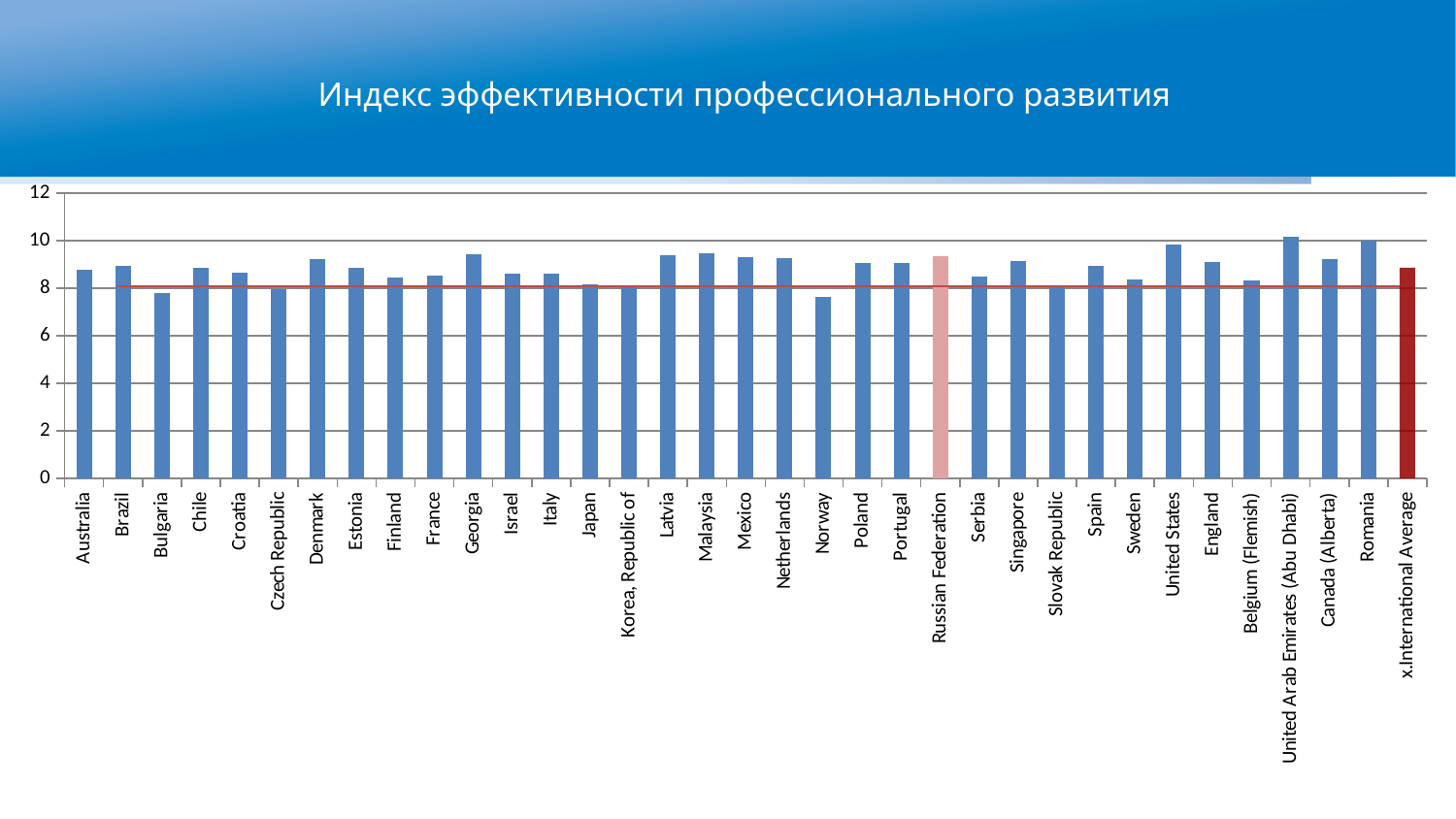
Which category has the lowest value? Norway Is the value for Georgia greater or less than 8? greater Is the value for Norway greater or less than 8? less How many categories (bars) are shown on the x axis? 35 Which is larger, the value for United States or the value for Slovak Republic? United States What is the title of the chart? Индекс эффективности профессионального развития Is the value for United Arab Emirates (Abu Dhabi) greater or less than 10? greater Which is larger, the value for Denmark or the value for Finland? Denmark Which category's bar is drawn in a lighter pink colour, different from the blue bars? Russian Federation Which is larger, the value for Norway or the value for Georgia? Georgia What type of chart is shown on the slide? bar chart